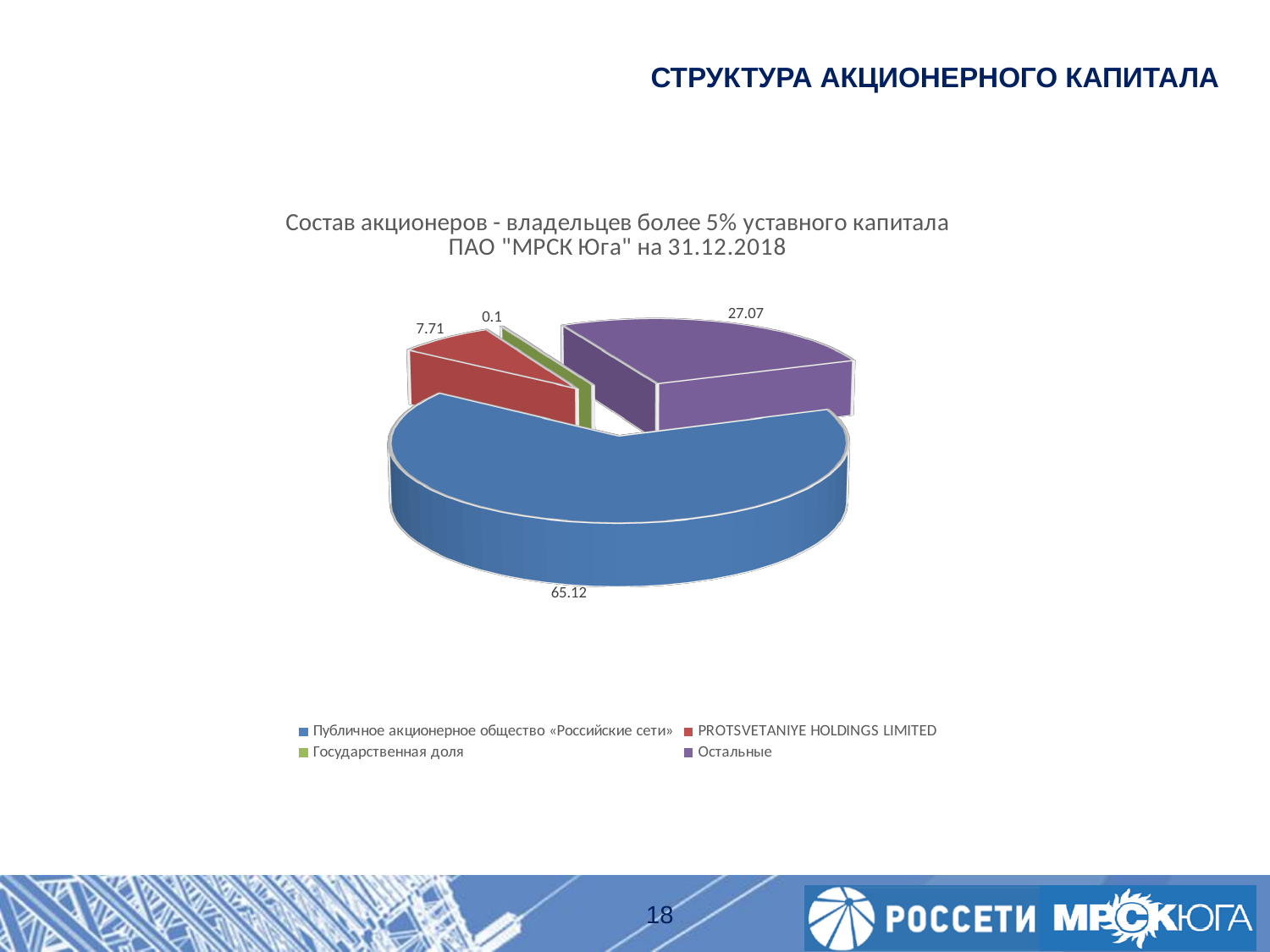
How many entries does the legend list? 4 How many slices does the pie chart have? 4 What is the difference between the values for Публичное акционерное общество «Российские сети» and Остальные? 38.05 What is the value for Государственная доля? 0.1 What is the value for Публичное акционерное общество «Российские сети»? 65.12 Which is larger, the value for PROTSVETANIYE HOLDINGS LIMITED or the value for Остальные? Остальные Which category has the smallest slice of the pie? Государственная доля What is the value for Остальные? 27.07 What is the value for PROTSVETANIYE HOLDINGS LIMITED? 7.71 What is the title of the chart? Состав акционеров - владельцев более 5% уставного капитала ПАО "МРСК Юга" на 31.12.2018 What kind of chart is shown on the slide? Pie chart Which category has the largest slice of the pie? Публичное акционерное общество «Российские сети»